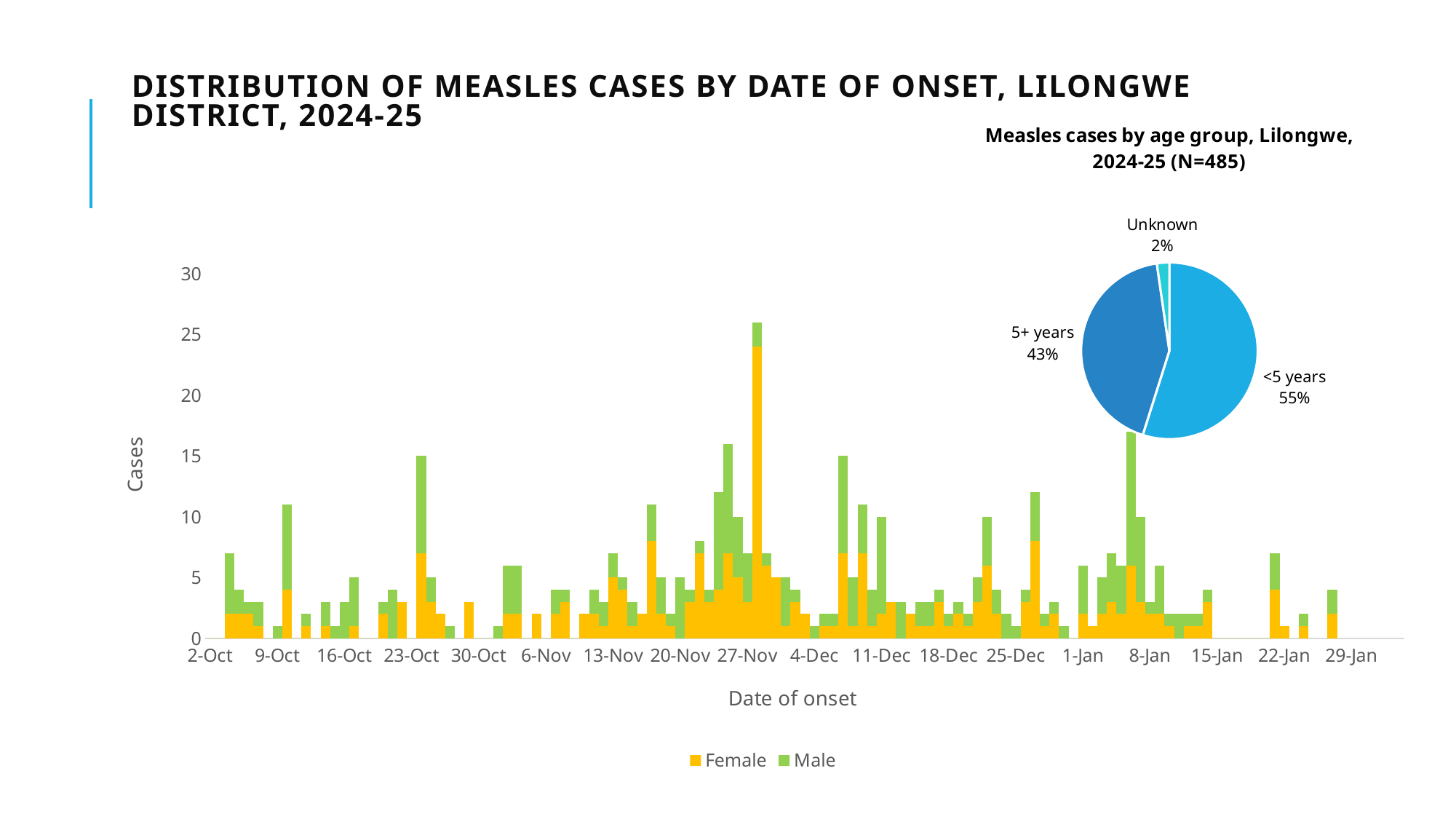
In the pie chart 'Measles cases by age group, Lilongwe, 2024-25 (N=485)', how many slices are shown? 3 In the pie chart 'Measles cases by age group, Lilongwe, 2024-25 (N=485)', what share of cases has an unknown age group? 2% What kind of chart is the 'Distribution of measles cases by date of onset, Lilongwe District, 2024-25' chart? Stacked bar chart In the pie chart 'Measles cases by age group, Lilongwe, 2024-25 (N=485)', which slice is the smallest? Unknown In the 'Distribution of measles cases by date of onset' chart, is the total for the tallest bar (around 27-Nov) greater or less than 20? greater In the pie chart 'Measles cases by age group, Lilongwe, 2024-25 (N=485)', which age group has the largest share? <5 years In the pie chart 'Measles cases by age group, Lilongwe, 2024-25 (N=485)', what share of cases is in the 5+ years group? 43% In the pie chart 'Measles cases by age group, Lilongwe, 2024-25 (N=485)', what share of cases is in the <5 years group? 55% In the 'Distribution of measles cases by date of onset' chart, what is the label on the y axis? Cases In the 'Distribution of measles cases by date of onset' chart, how many series does the legend list? 2 In the pie chart 'Measles cases by age group, Lilongwe, 2024-25 (N=485)', how many percentage points larger is the <5 years share than the 5+ years share? 12 percentage points